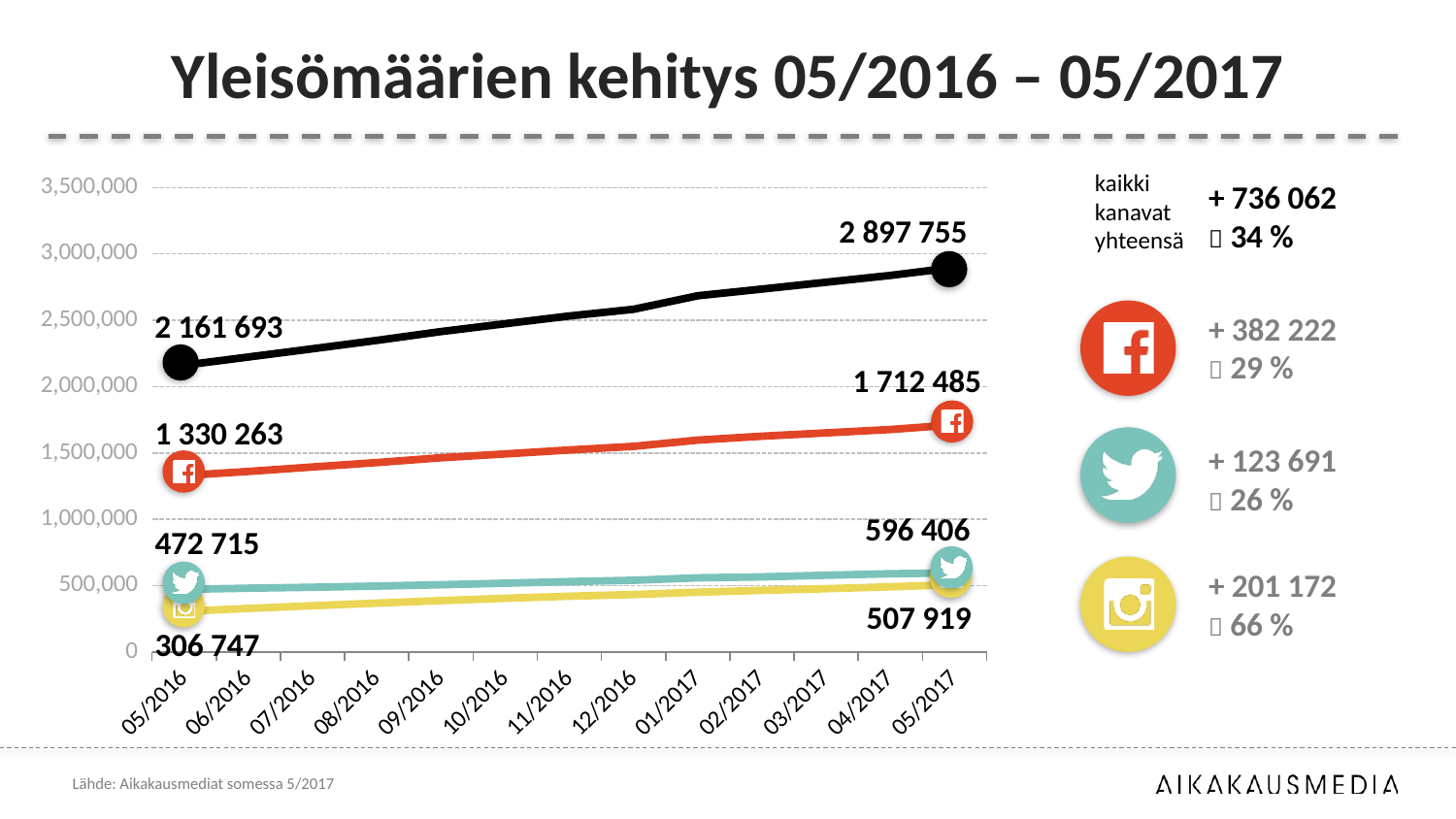
What type of chart is shown on the slide? line chart Do the lines rise or fall from 05/2016 to 05/2017? rise How many months are shown on the x axis? 13 What is the difference between the Facebook values at 05/2017 and 05/2016? 382 222 Which line has the lowest value at 05/2016? Instagram (yellow) What is the value of the Facebook (red) line at 05/2016? 1 330 263 What is the value of the Twitter (teal) line at 05/2017? 596 406 At 05/2017, which is larger: the Twitter value or the Instagram value? Twitter What is the value of the black (total) line at 05/2017? 2 897 755 What is the value of the Instagram (yellow) line at 05/2016? 306 747 By how much did the black (total) line increase from 05/2016 to 05/2017? 736 062 What is the title of the chart? Yleisömäärien kehitys 05/2016 – 05/2017